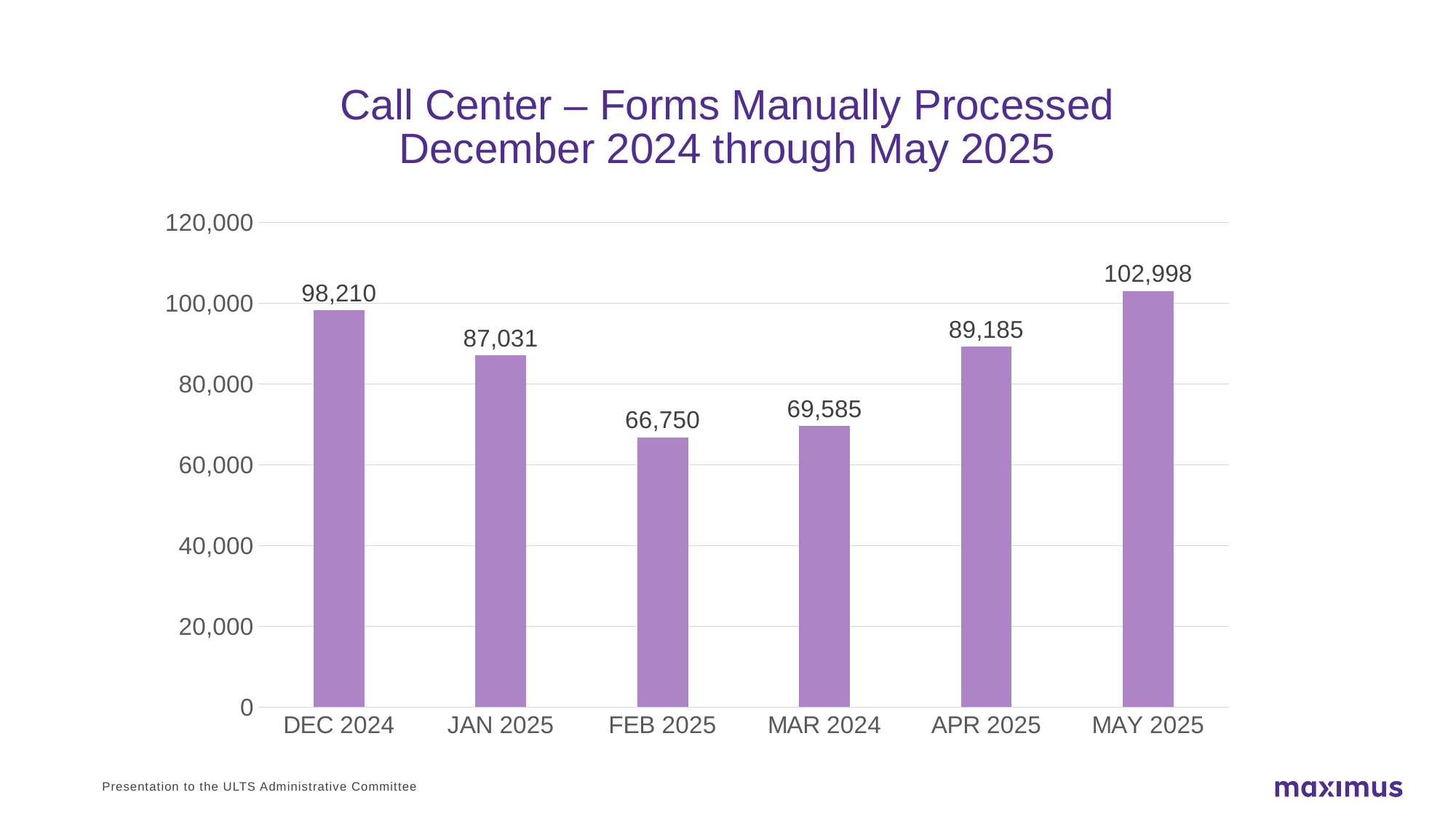
What is the difference between the values for MAY 2025 and DEC 2024? 4,788 Which month has the highest number of forms manually processed? MAY 2025 Is the value for MAY 2025 greater or less than 100,000? greater What kind of chart is shown on the slide? Bar chart Which is larger, the value for JAN 2025 or the value for APR 2025? APR 2025 What is the value shown for APR 2025? 89,185 What is the title of the chart? Call Center – Forms Manually Processed December 2024 through May 2025 Which month has the lowest number of forms manually processed? FEB 2025 What is the difference between the values for APR 2025 and the bar labelled MAR 2024? 19,600 How many forms were manually processed in DEC 2024? 98,210 How many months are shown on the chart? 6 What is the value shown for FEB 2025? 66,750